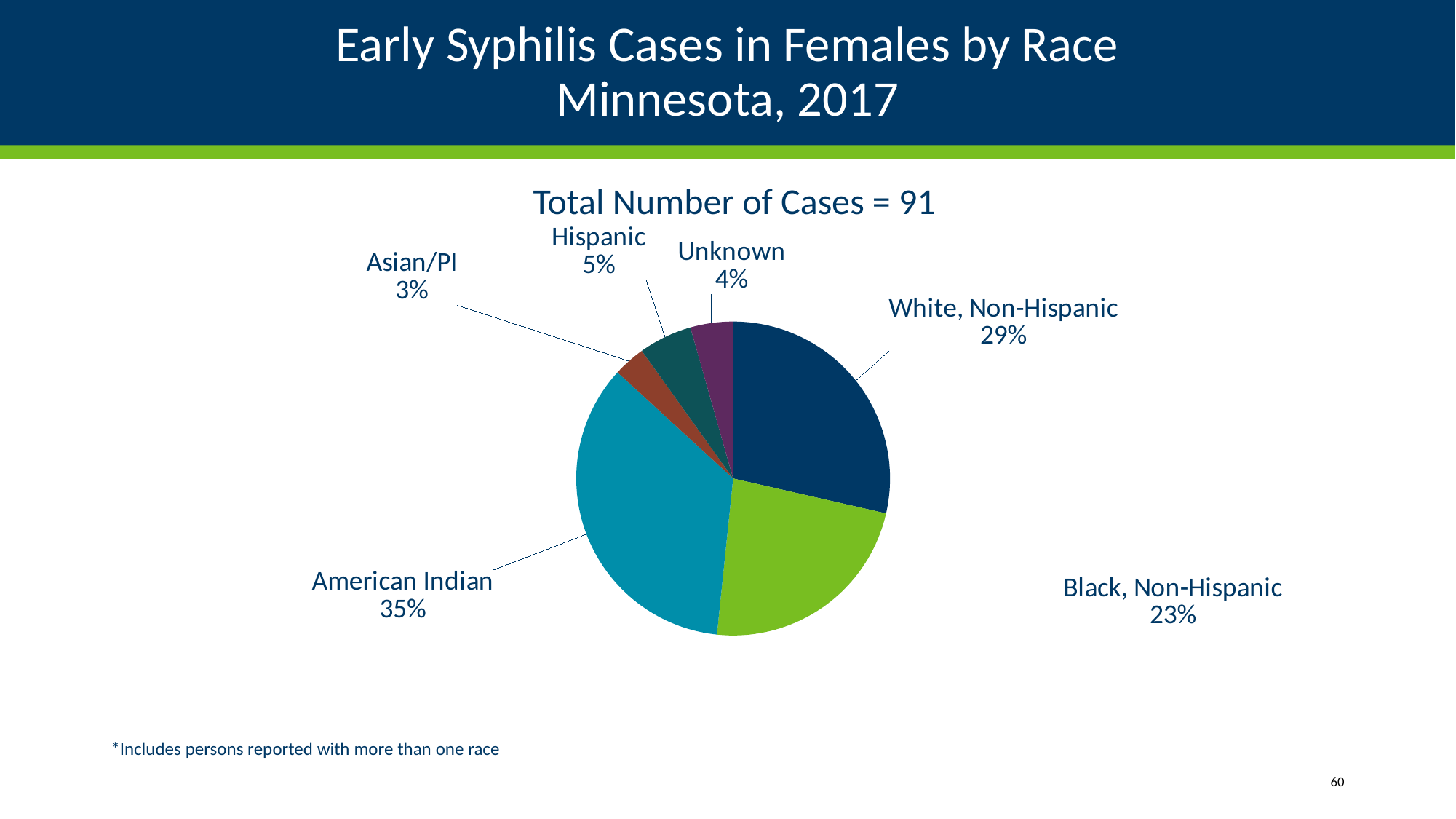
What share of cases is Hispanic? 5% What kind of chart is shown on the slide? pie chart Which race category has the smallest share of cases? Asian/PI Which race category has the largest share of cases? American Indian What share of early syphilis cases in females is American Indian? 35% Which is larger, the share for Black, Non-Hispanic or the share for White, Non-Hispanic? White, Non-Hispanic What share of cases is Unknown? 4% What is the total number of cases stated above the chart? 91 What is the difference in percentage points between the American Indian and White, Non-Hispanic shares? 6 How many race categories are shown in the pie chart? 6